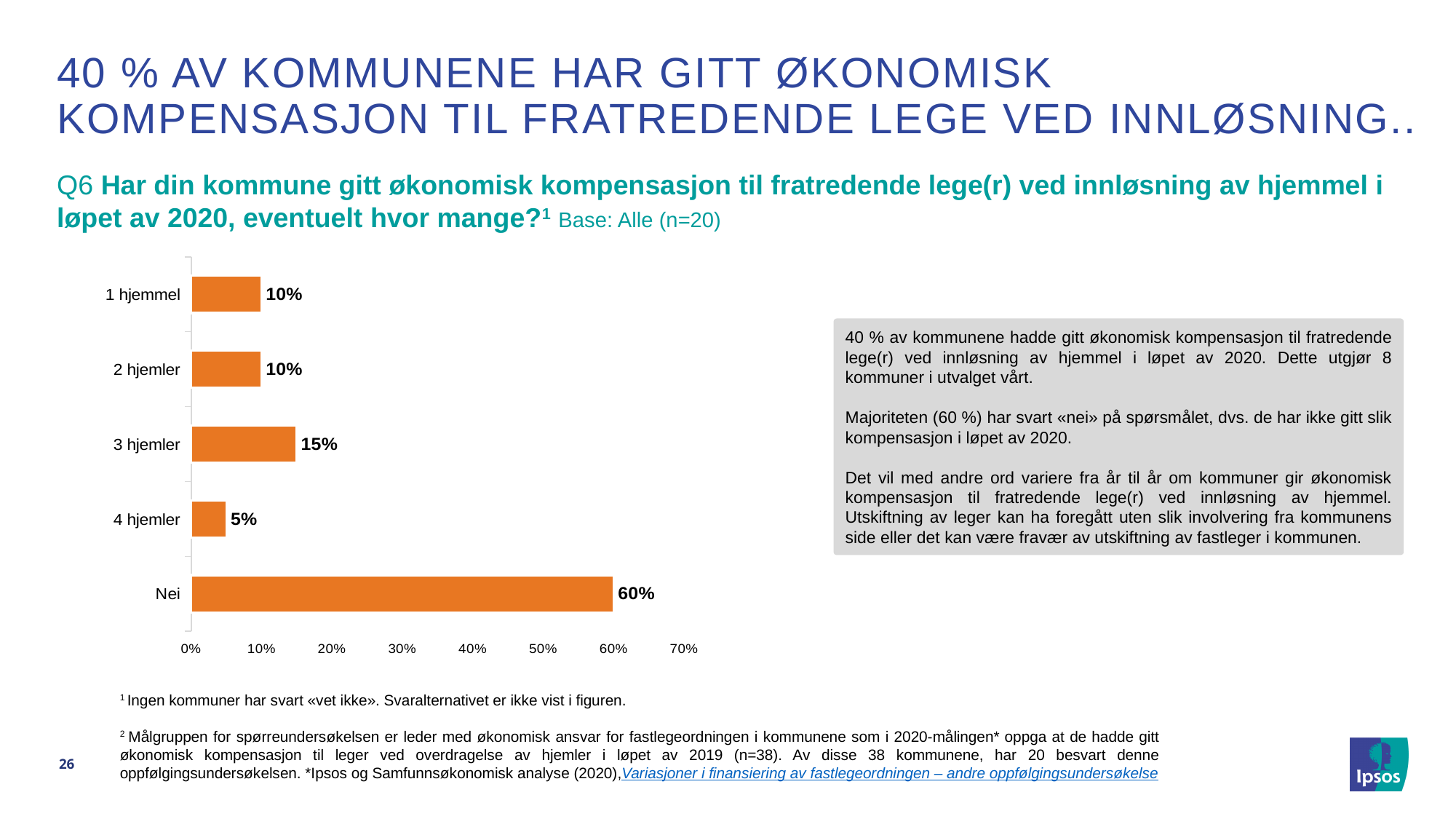
What is the total of the values for "1 hjemmel", "2 hjemler", "3 hjemler" and "4 hjemler"? 40% How many categories are shown in the chart? 5 Which is larger, the value for "3 hjemler" or the value for "2 hjemler"? 3 hjemler What is the highest value shown on the x axis of the chart? 70% Which category has the highest value? Nei What is the value for "4 hjemler"? 5% What kind of chart is shown on the slide? Bar chart What is the value for "3 hjemler"? 15% What is the value for "Nei"? 60% Which category has the lowest value? 4 hjemler What is the difference between the values for "Nei" and "3 hjemler"? 45% What is the value for "1 hjemmel"? 10%